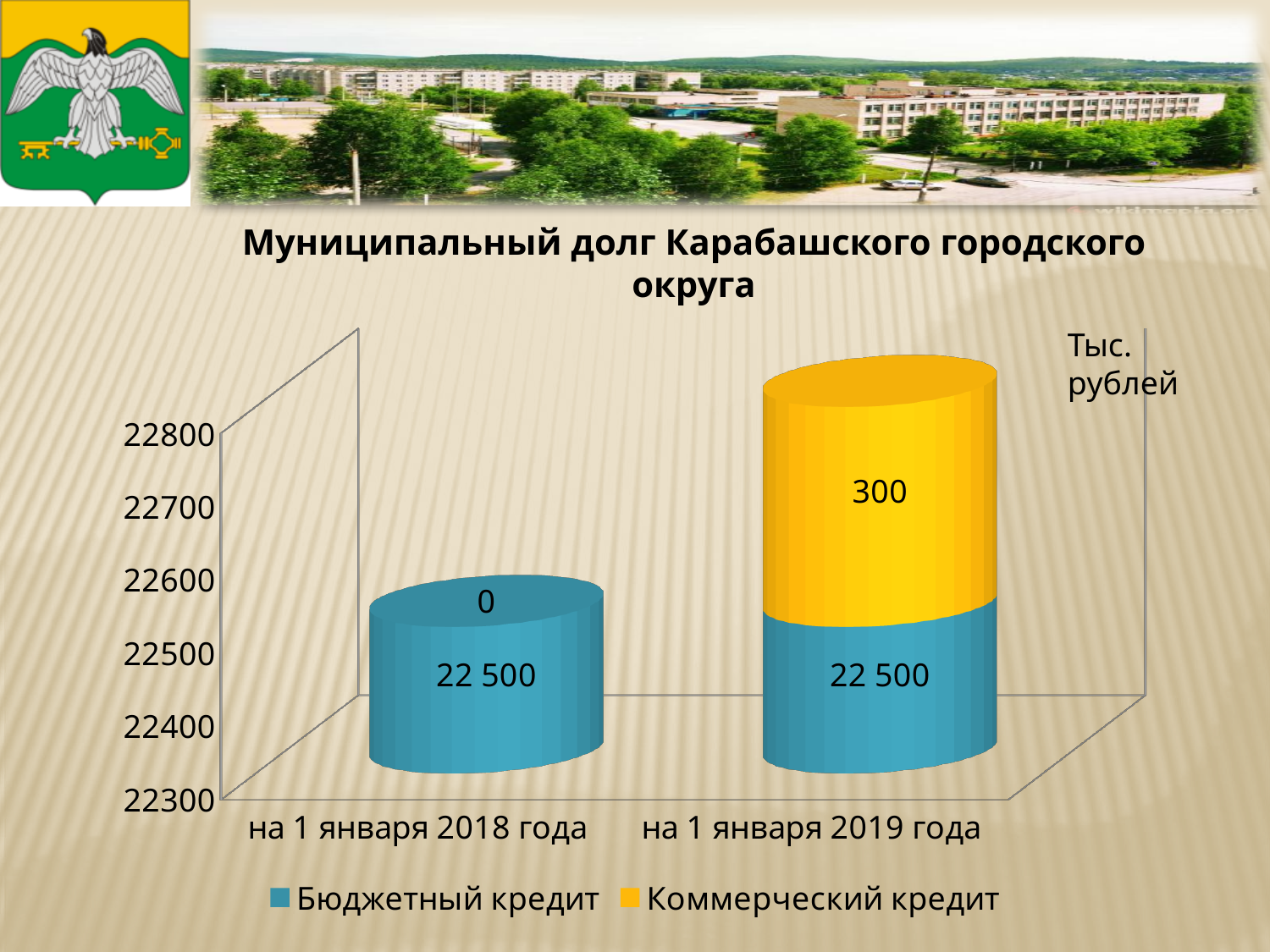
How many categories (dates) are shown on the x axis? 2 How many series does the legend list? 2 What is the value of Коммерческий кредит on 1 января 2018 года? 0 What is the value of Коммерческий кредит on 1 января 2019 года? 300 What unit of measurement is indicated on the chart? Тыс. рублей Which date has the higher total municipal debt? на 1 января 2019 года What is the value of Бюджетный кредит on 1 января 2018 года? 22 500 What kind of chart is shown on the slide? Stacked bar chart What is the total municipal debt (sum of both series) on 1 января 2018 года? 22 500 What is the value of Бюджетный кредит on 1 января 2019 года? 22 500 By how much did Коммерческий кредит change from 1 января 2018 года to 1 января 2019 года? 300 What is the total municipal debt (sum of both series) on 1 января 2019 года? 22 800